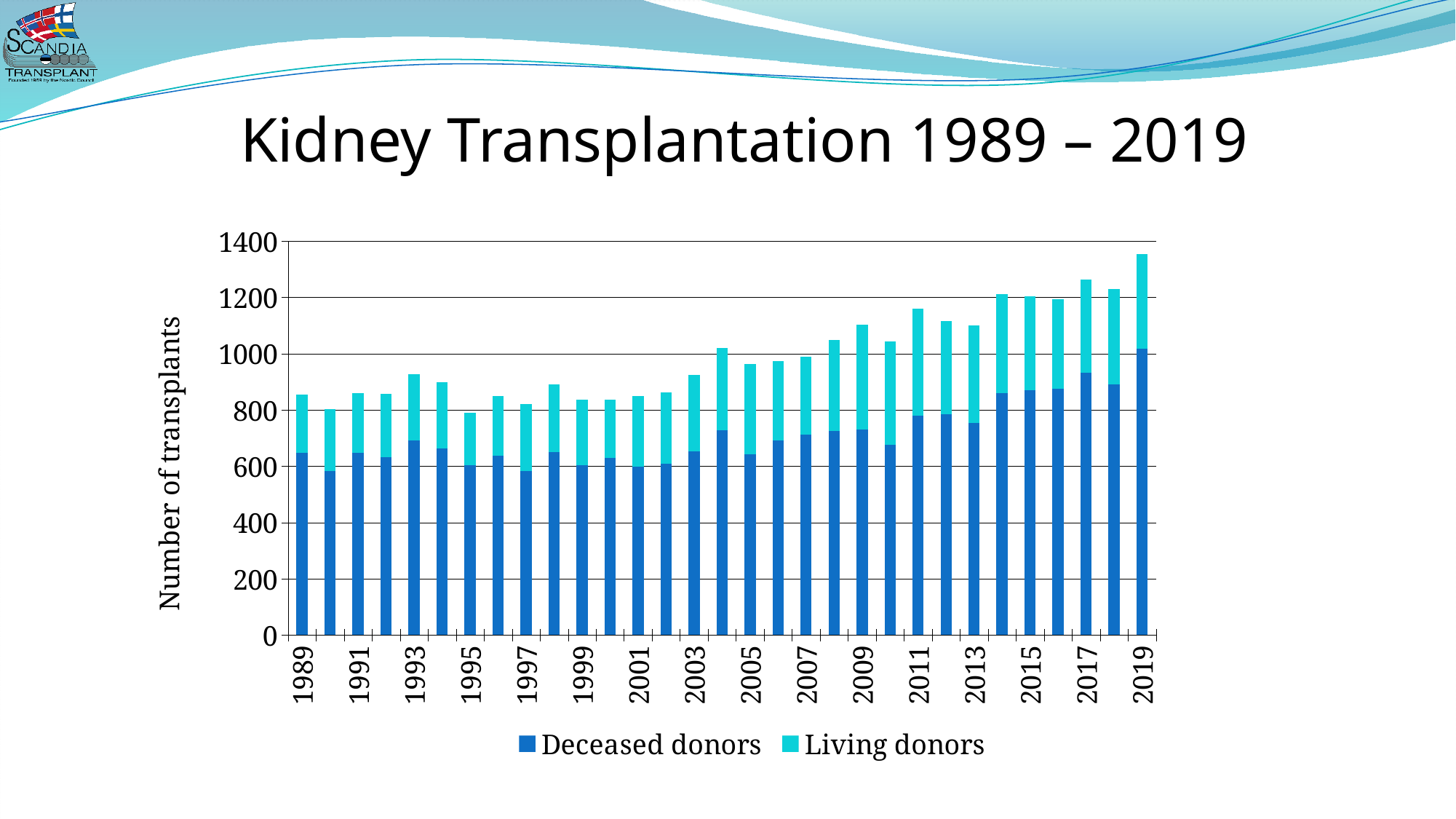
How many years (bars) are plotted in the chart? 31 What are the two series named in the legend? Deceased donors and Living donors Which year has the highest total number of transplants? 2019 What kind of chart is shown on the slide? Stacked bar chart Is the total number of transplants in 1995 greater or less than 1000? less Is the total number of transplants in 2019 greater or less than 1200? greater Overall, do total transplants rise or fall from 1989 to 2019? rise Is the number of transplants from deceased donors in 2013 greater or less than 800? less What is the title of the chart? Kidney Transplantation 1989 – 2019 How many series does the legend list? 2 Which year has a larger total number of transplants, 1989 or 2019? 2019